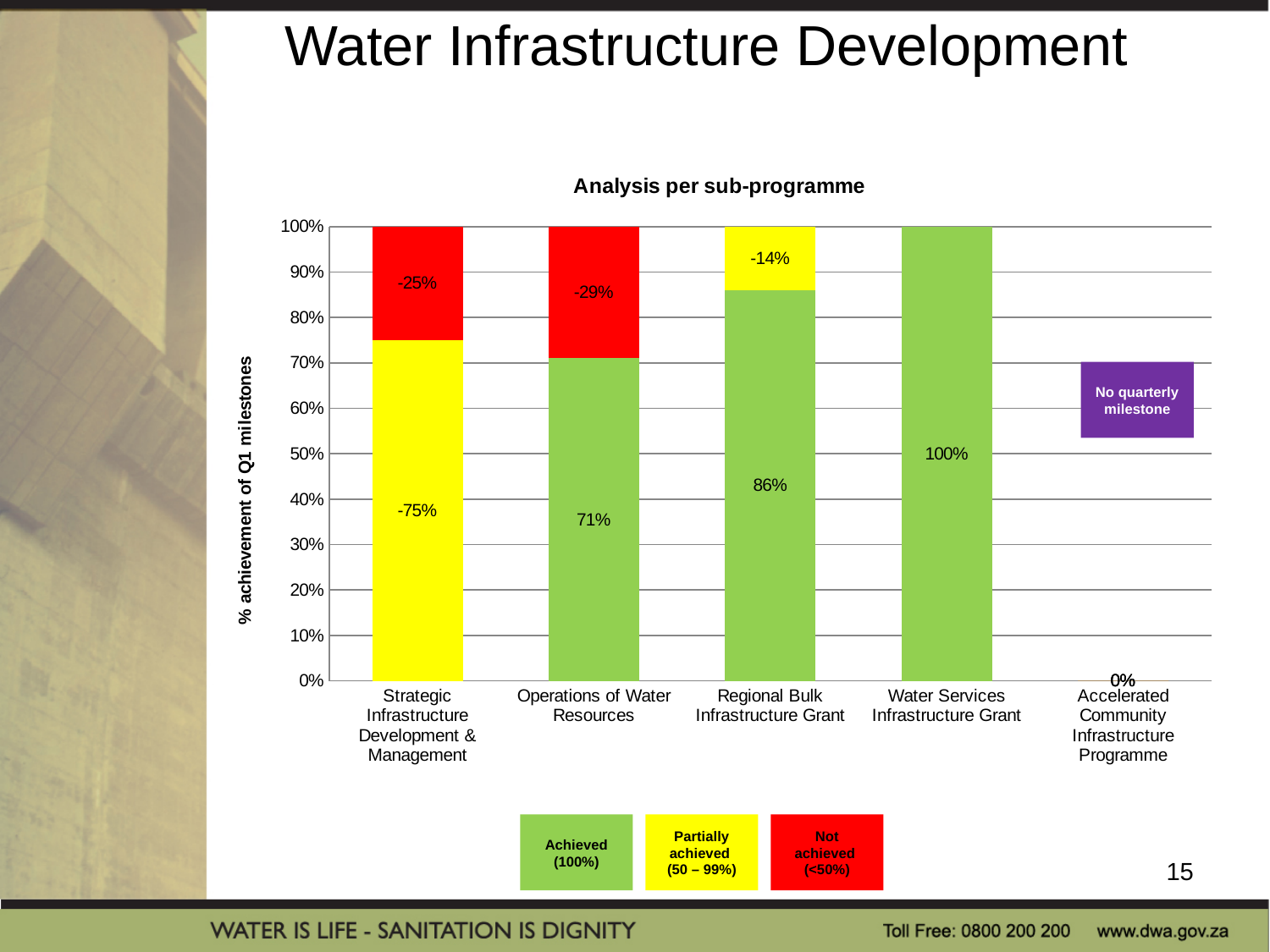
What value is printed on the green segment for Regional Bulk Infrastructure Grant? 86% What value is printed on the green segment for Water Services Infrastructure Grant? 100% How many entries does the legend below the chart list? 3 Which sub-programme has the largest green (Achieved) segment? Water Services Infrastructure Grant What is the title of the chart? Analysis per sub-programme What value is printed on the green segment for Operations of Water Resources? 71% What type of chart is shown on the slide? Stacked bar chart What value is printed on the yellow segment for Strategic Infrastructure Development & Management? -75% Is the green segment for Regional Bulk Infrastructure Grant larger or smaller than the green segment for Operations of Water Resources? Larger What text is shown in the purple box above the Accelerated Community Infrastructure Programme category? No quarterly milestone How many sub-programme categories are shown on the x axis? 5 What value is printed on the red segment for Operations of Water Resources? -29%